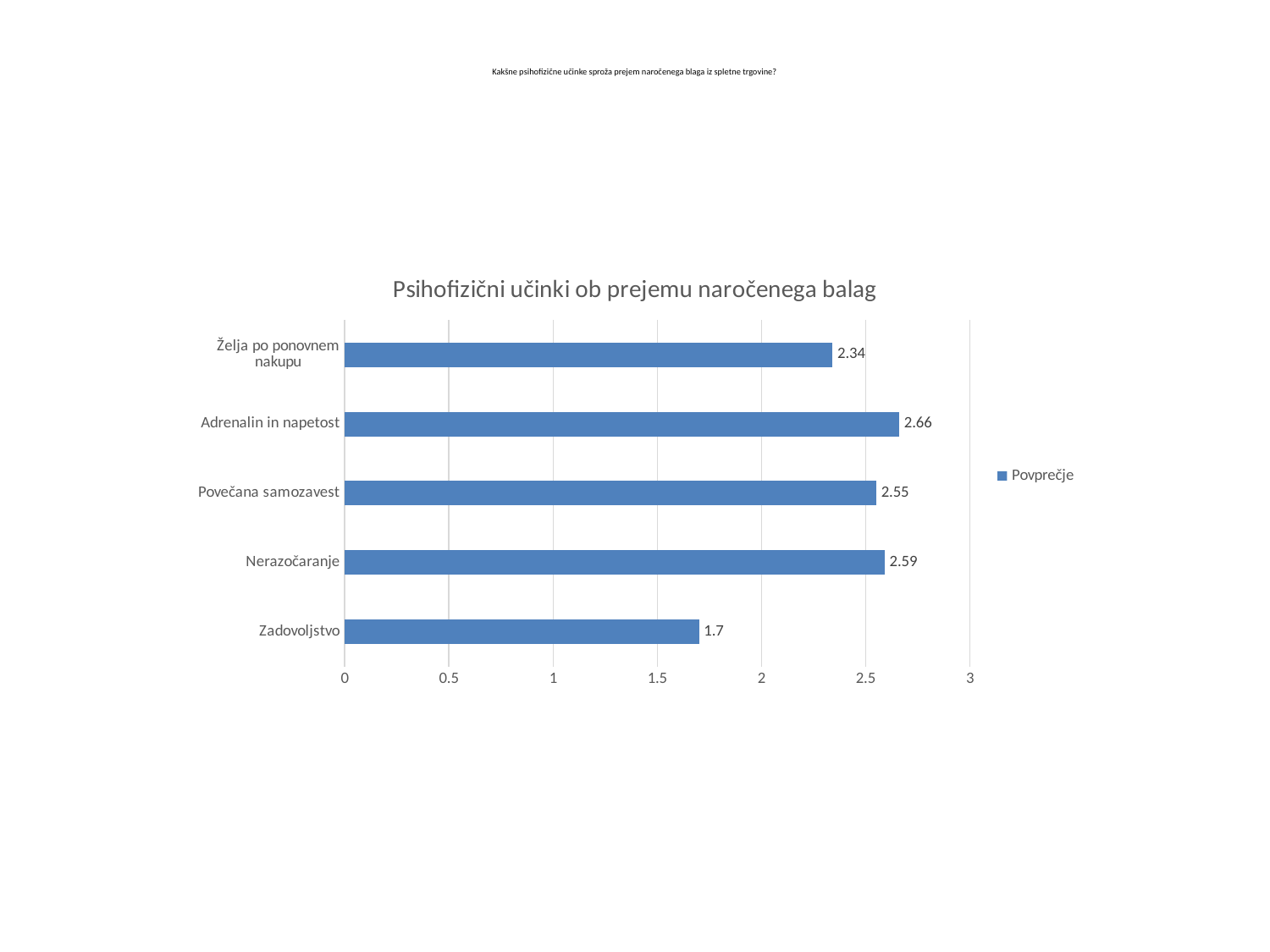
Which category has the lowest value? Zadovoljstvo What kind of chart is shown? bar chart What is the value for Zadovoljstvo? 1.7 Which category has the highest value? Adrenalin in napetost What is the value for Adrenalin in napetost? 2.66 What is the difference between the values for Nerazočaranje and Zadovoljstvo? 0.89 How many series does the legend list? 1 What is the title of the chart? Psihofizični učinki ob prejemu naročenega balag Is the value for Nerazočaranje greater or less than 2.5? greater How many categories are shown in the chart? 5 What is the value for Želja po ponovnem nakupu? 2.34 Which is larger, the value for Povečana samozavest or the value for Želja po ponovnem nakupu? Povečana samozavest